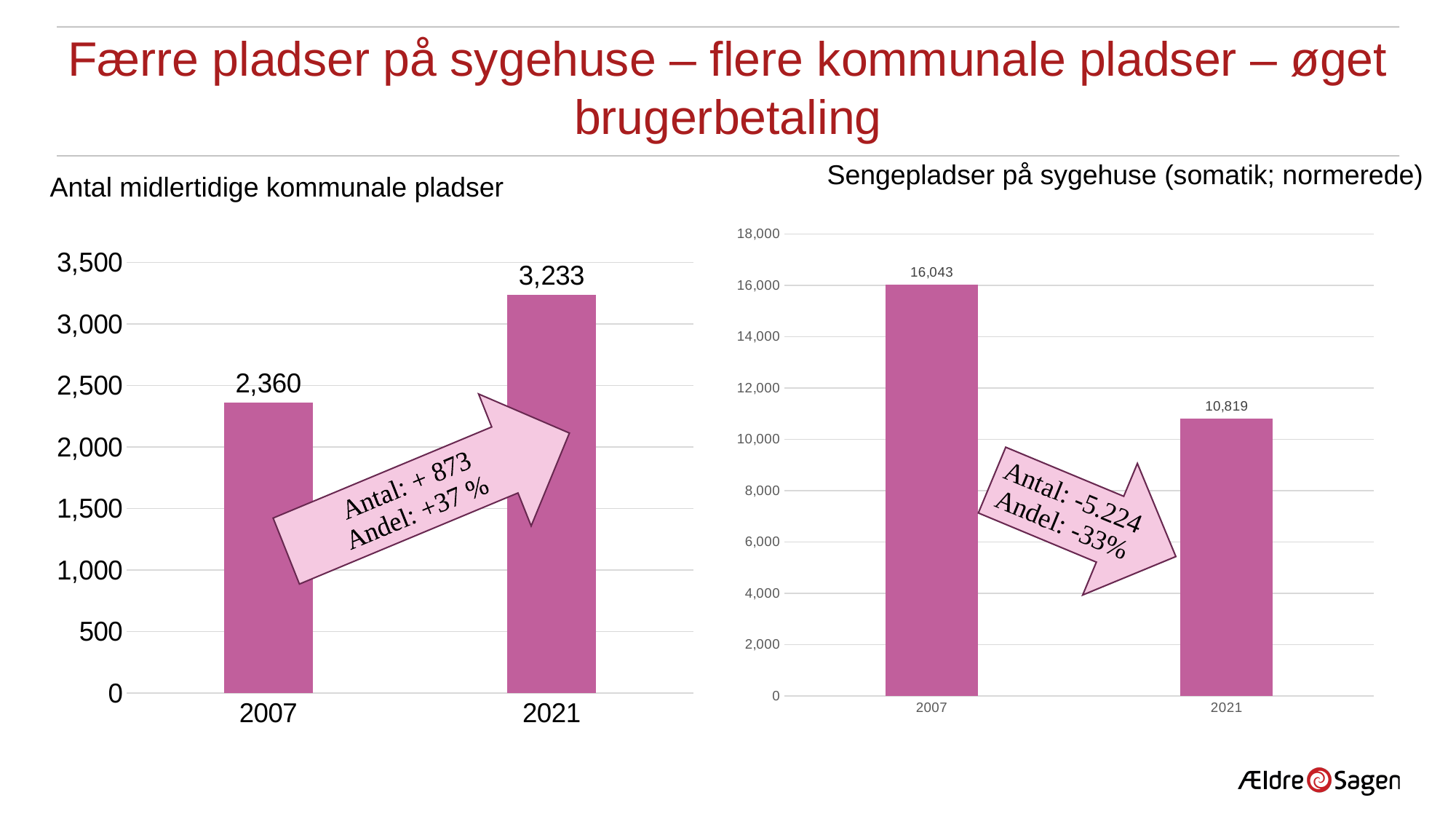
In the chart 'Antal midlertidige kommunale pladser', what is the value for 2021? 3,233 In the chart 'Sengepladser på sygehuse (somatik; normerede)', what is the difference between the 2007 and 2021 values? 5,224 In the chart 'Antal midlertidige kommunale pladser', which year has the higher value? 2021 In the chart 'Sengepladser på sygehuse (somatik; normerede)', is the value for 2021 greater or less than 12,000? less In the chart 'Sengepladser på sygehuse (somatik; normerede)', which year has the lower value? 2021 What kind of chart is 'Sengepladser på sygehuse (somatik; normerede)'? bar chart In the chart 'Antal midlertidige kommunale pladser', do the values rise or fall from 2007 to 2021? rise In the chart 'Sengepladser på sygehuse (somatik; normerede)', what is the value for 2021? 10,819 In the chart 'Antal midlertidige kommunale pladser', what is the value for 2007? 2,360 How many bars are shown in the chart 'Antal midlertidige kommunale pladser'? 2 In the chart 'Antal midlertidige kommunale pladser', what is the difference between the 2021 and 2007 values? 873 In the chart 'Sengepladser på sygehuse (somatik; normerede)', what is the value for 2007? 16,043